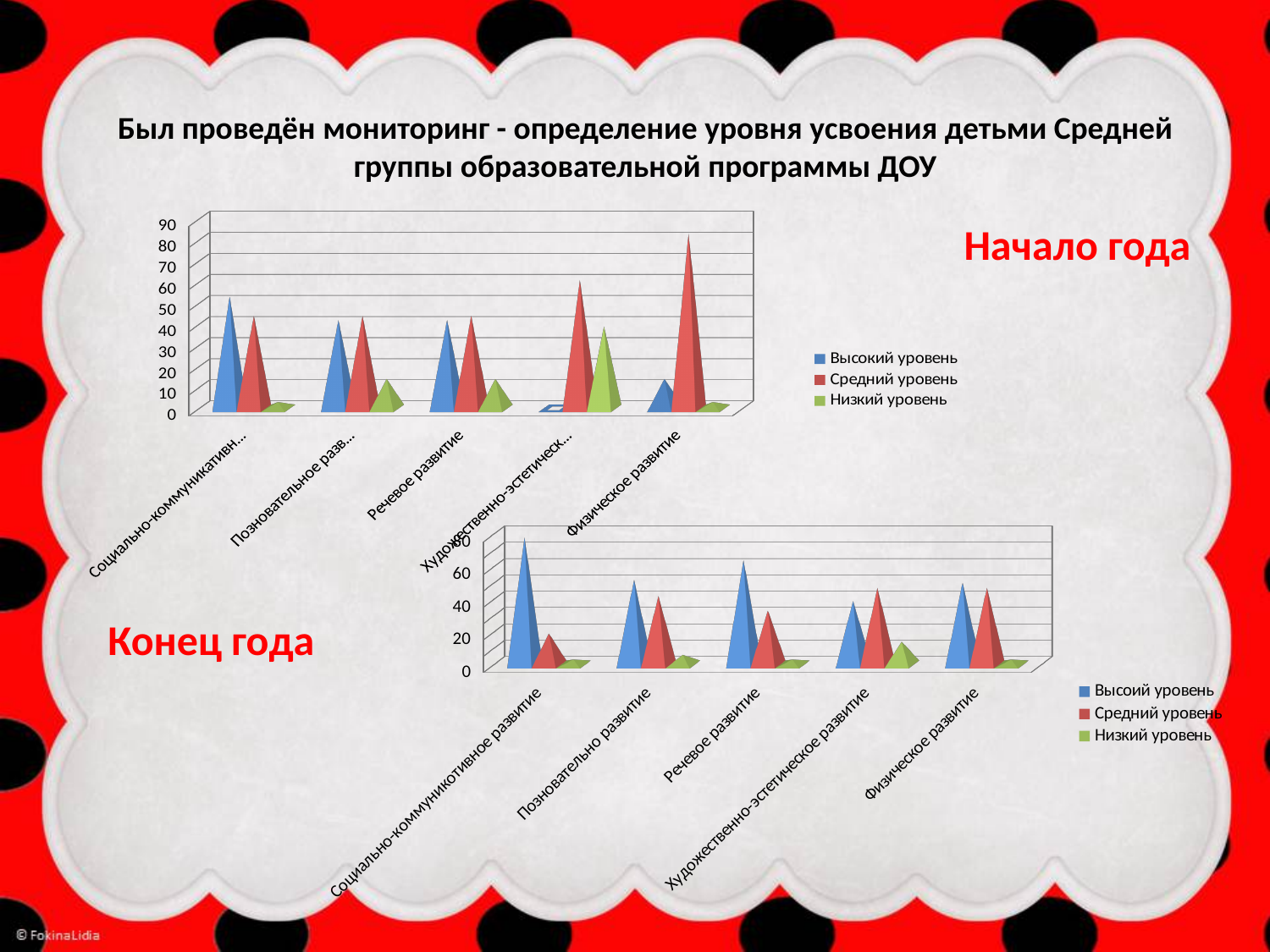
What kind of chart is the 'Конец года' chart? bar chart In the 'Конец года' chart, for Речевое развитие, which is larger: Высокий уровень or Средний уровень? Высокий уровень In the 'Начало года' chart, which category has the highest value for Низкий уровень? Художественно-эстетическое развитие In the 'Конец года' chart, which category has the highest value for Высокий уровень? Социально-коммуникотивное развитие In the 'Начало года' chart, which category has the highest value for Средний уровень? Физическое развитие In the 'Начало года' chart, how many series does the legend list? 3 What label in red text is placed next to the top chart? Начало года In the 'Начало года' chart, is the Средний уровень value for Физическое развитие greater or less than 70? greater In the 'Конец года' chart, is the Высокий уровень value for Социально-коммуникативное развитие greater or less than 60? greater In the 'Конец года' chart, is the Средний уровень value for Социально-коммуникативное развитие greater or less than 40? less In the 'Начало года' chart, how many categories are shown on the x axis? 5 In the 'Начало года' chart, for Физическое развитие, which is larger: Высокий уровень or Средний уровень? Средний уровень